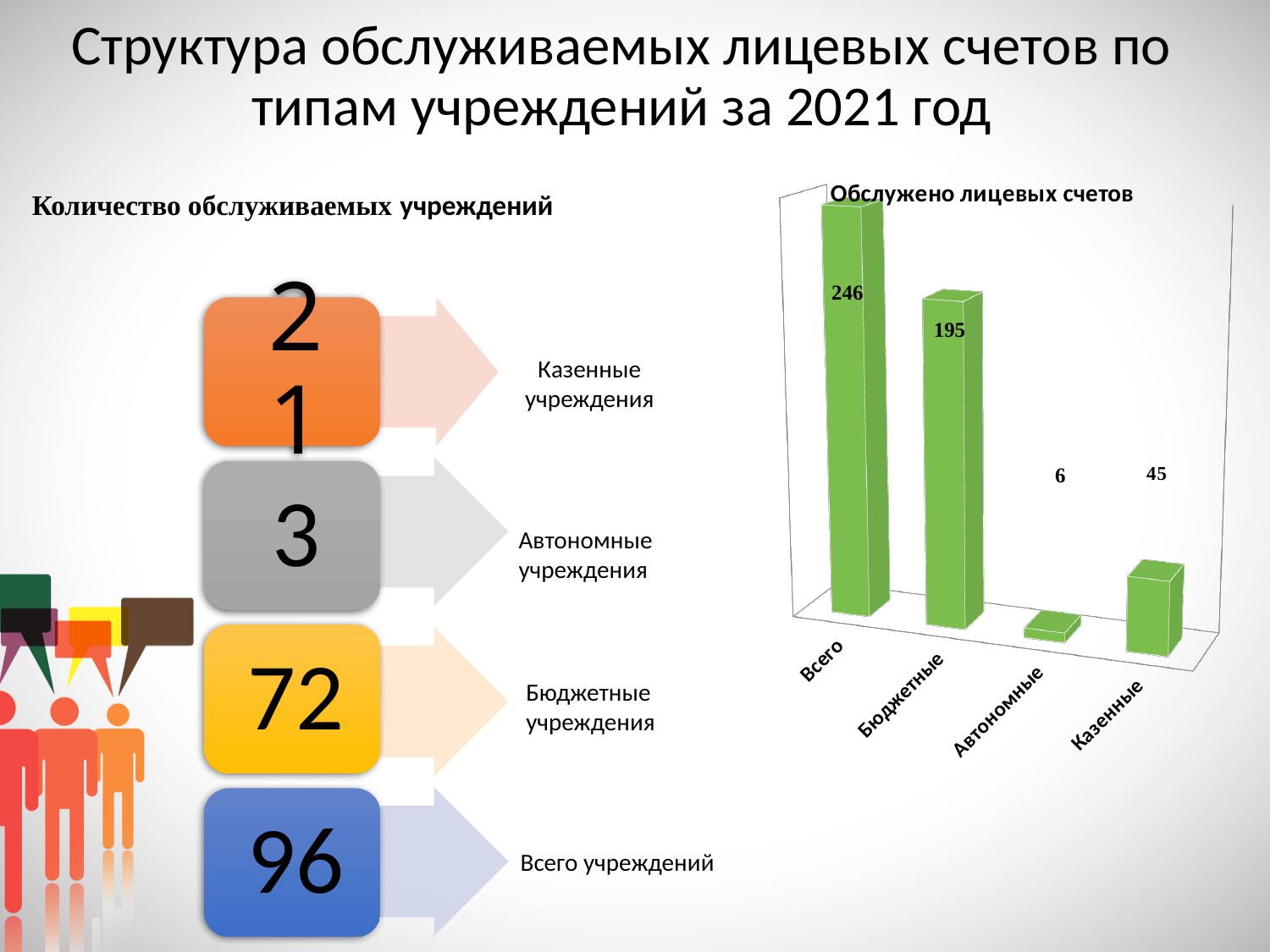
What is the value for Бюджетные in the chart? 195 What kind of chart is shown on the slide? bar chart What is the difference between the values for Всего and Бюджетные? 51 What is the difference between the values for Казенные and Автономные? 39 What is the title of the chart on the slide? Обслужено лицевых счетов What is the value for Автономные in the chart? 6 What is the value for Всего in the chart? 246 Which category has the highest value in the chart? Всего How many categories are shown in the chart? 4 Which is larger, the value for Казенные or the value for Автономные? Казенные What is the value for Казенные in the chart? 45 Which category has the lowest value in the chart? Автономные